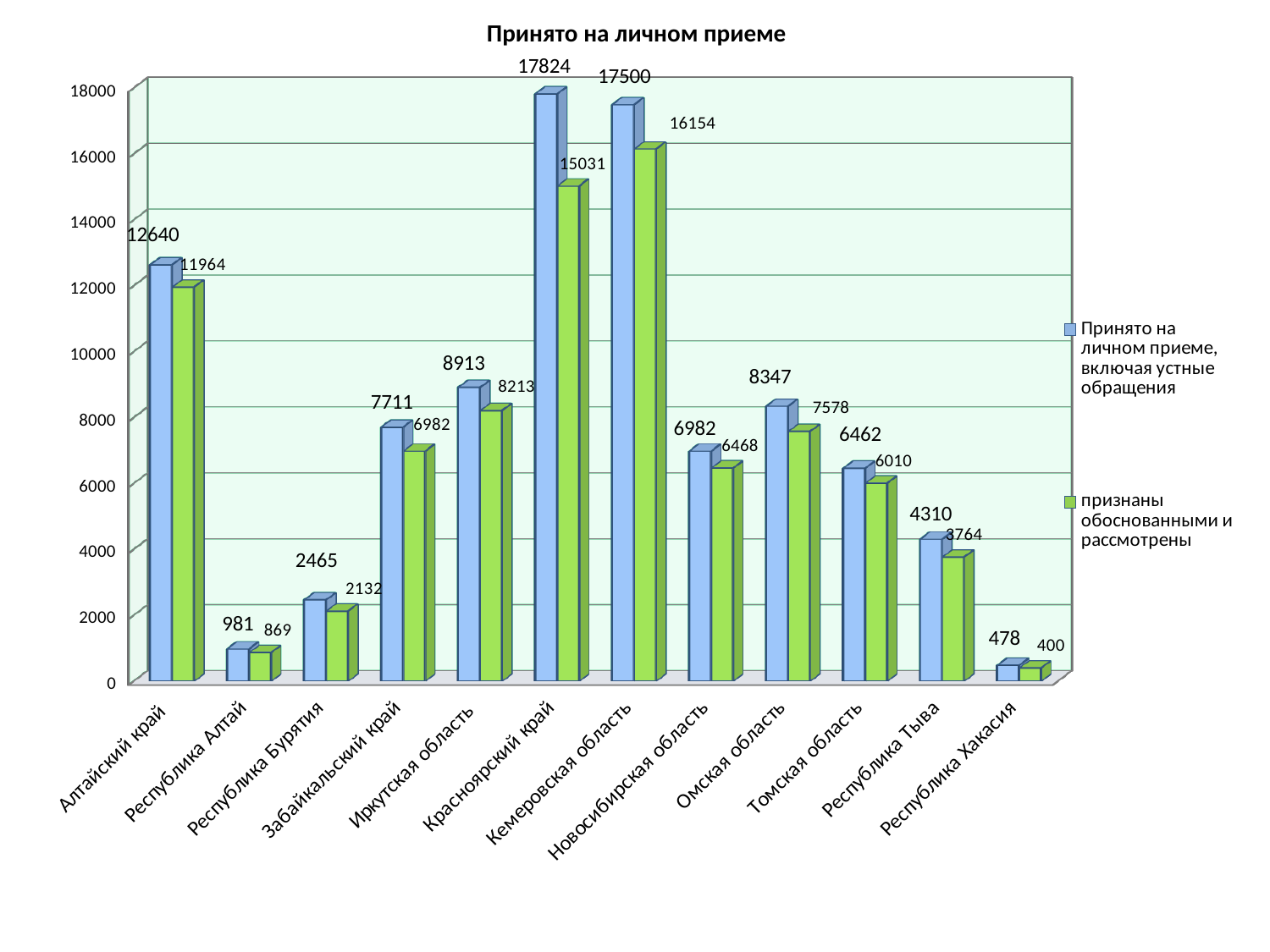
Is the value of 'Принято на личном приеме' for Томская область greater or less than 6000? greater How many regions are shown on the x axis? 12 Which region has the highest value for 'Принято на личном приеме, включая устные обращения'? Красноярский край What is the value of 'Принято на личном приеме, включая устные обращения' for Красноярский край? 17824 What is the value of 'признаны обоснованными и рассмотрены' for Кемеровская область? 16154 What is the difference between 'Принято на личном приеме' for Красноярский край and Кемеровская область? 324 Which is larger: 'Принято на личном приеме' for Иркутская область or for Омская область? Иркутская область What is the value of 'признаны обоснованными и рассмотрены' for Республика Тыва? 3764 What is the difference between the two series values for Алтайский край? 676 How many series does the legend list? 2 Which region has the lowest value for 'признаны обоснованными и рассмотрены'? Республика Хакасия What type of chart is shown on the slide? bar chart